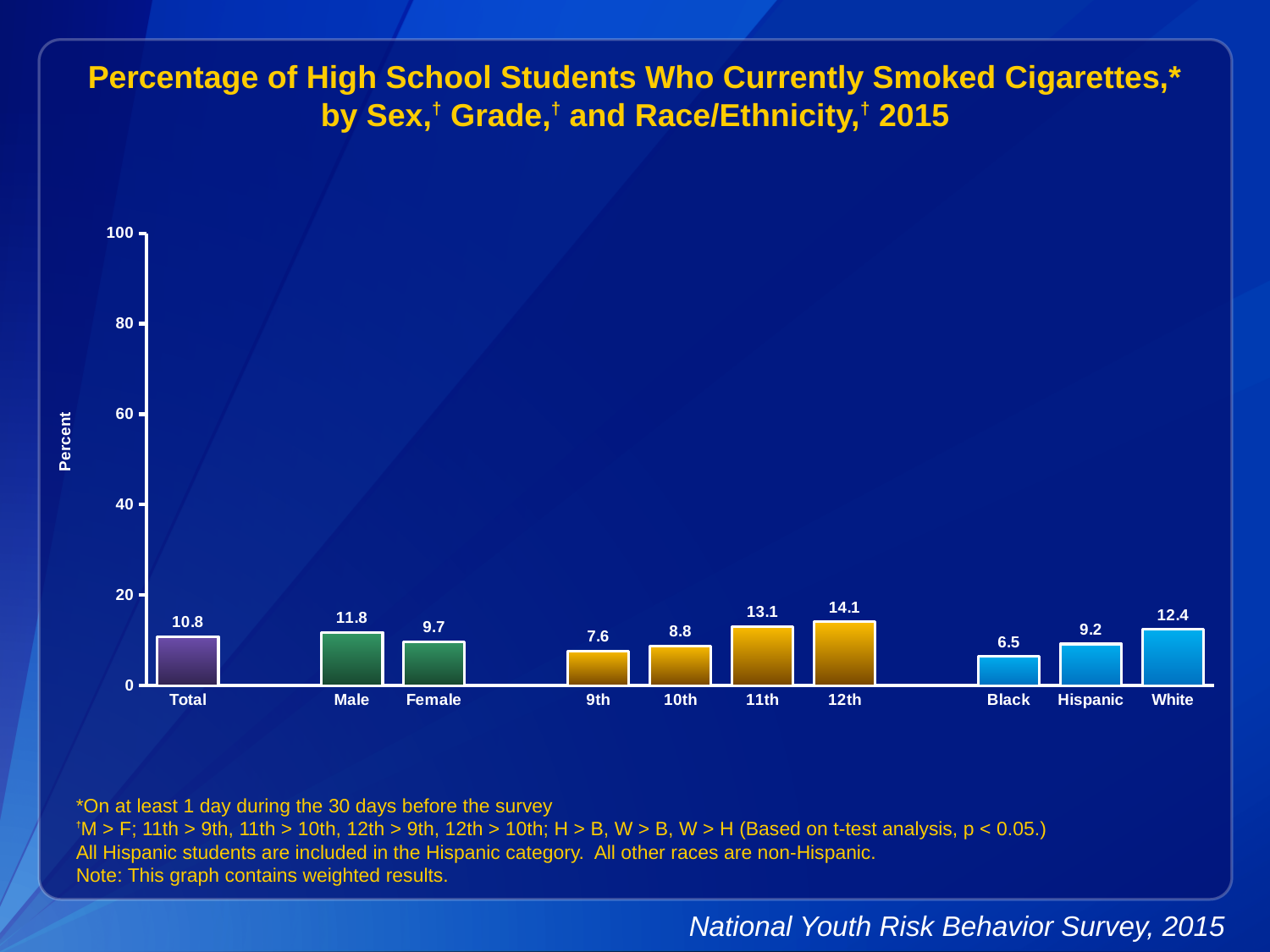
What is the value for Hispanic? 9.2 Which is larger, the value for 11th grade or the value for 10th grade? 11th How many categories are shown on the x axis? 10 What kind of chart is this? bar chart What is the value for 12th grade? 14.1 Which category has the lowest value? Black What is the difference between the values for Male and Female? 2.1 What is the value for Total? 10.8 What is the value for Female? 9.7 What is the difference between the values for White and Black? 5.9 Which category has the highest value? 12th Is the value for 12th grade greater or less than 20? less